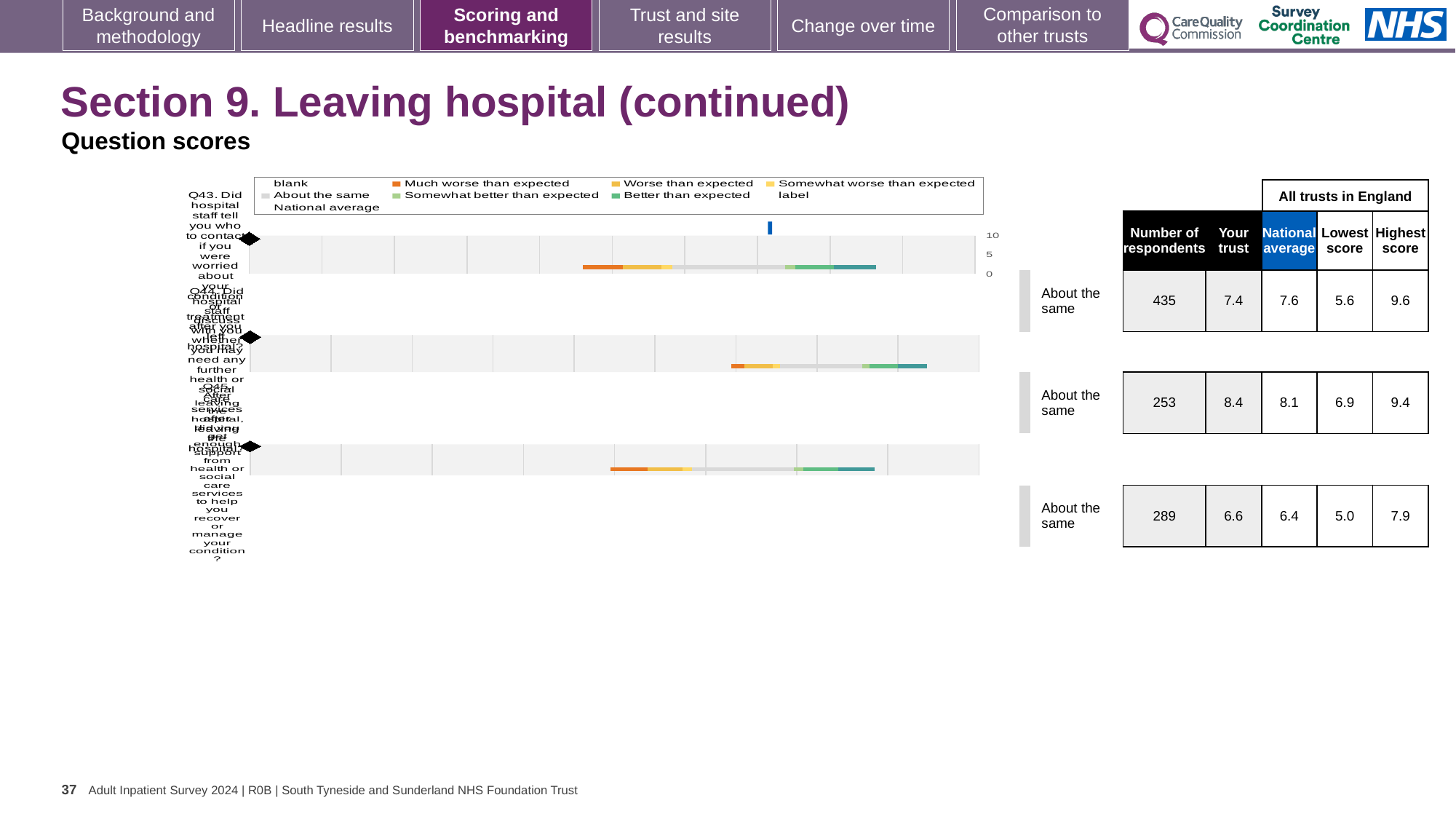
What is the highest value shown on the chart axis? 10 In the table, which question has the highest 'Your trust' score? Q44 (8.4) In the table, what is the difference between the highest score and lowest score for Q45? 2.9 In the table, what is the national average for the second question (Q44)? 8.1 What benchmark category is shown beside each of the three charts? About the same Which legend entry is shown in orange? Much worse than expected How many separate question charts are shown on the slide? 3 In the table, how many respondents answered the third question (Q45)? 289 In the table, what is the 'Your trust' score for the first question (Q43)? 7.4 What kind of chart is used to show the question scores on this slide? bar chart In the table, is the 'Your trust' score for Q43 larger or smaller than the national average? smaller